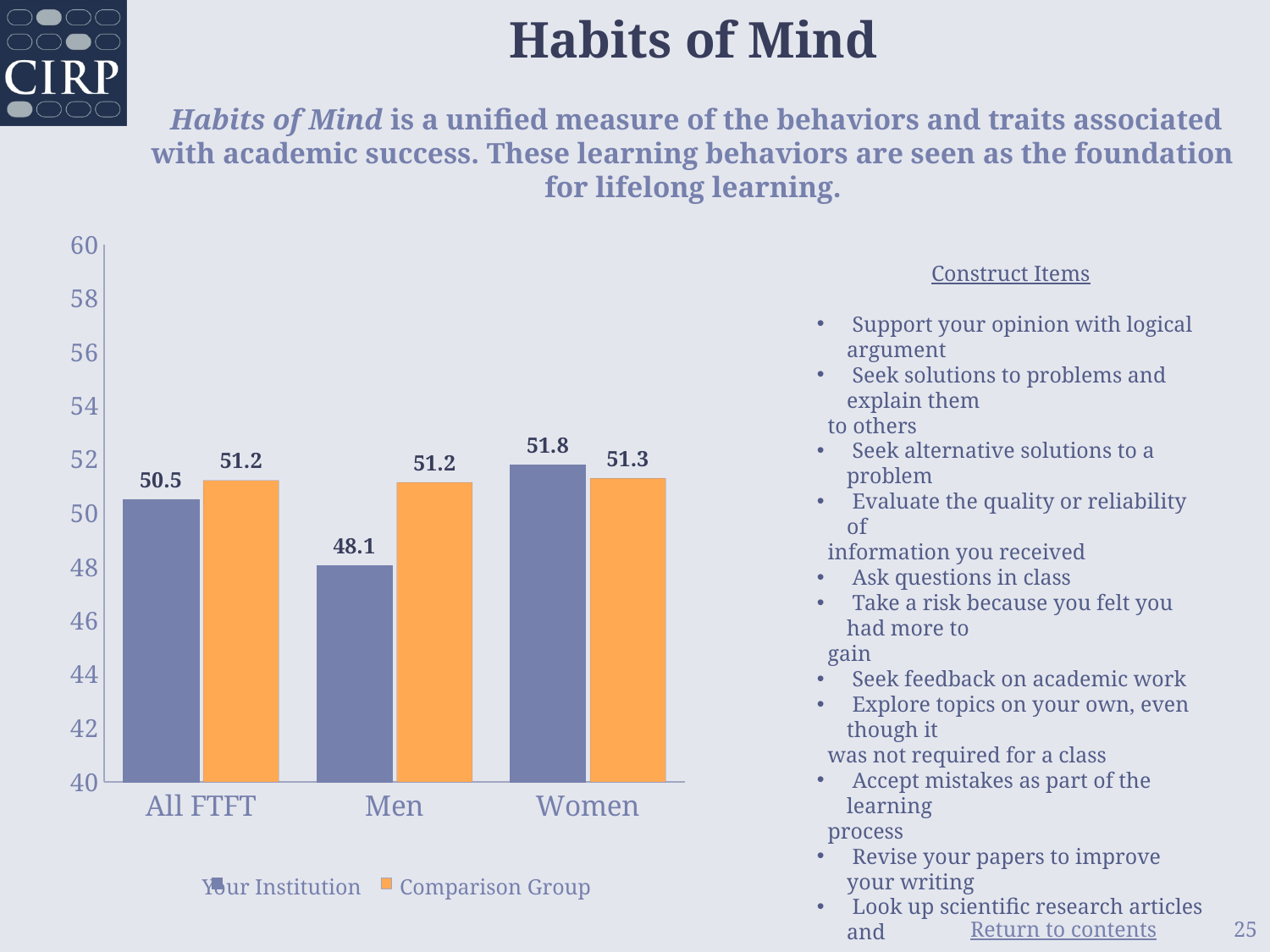
What is the Comparison Group value for Women? 51.3 What is the Comparison Group value for Men? 51.2 How many series does the legend list? 2 Which category has the lowest Your Institution value? Men Which category has the highest Your Institution value? Women What is the Your Institution value for Men? 48.1 What kind of chart is shown on the slide? bar chart What is the Your Institution value for All FTFT? 50.5 Is the Your Institution value for Men greater or less than 50? less What is the difference between the Comparison Group and Your Institution values for Men? 3.1 For Women, which is larger: Your Institution or Comparison Group? Your Institution How many categories are shown on the x axis? 3